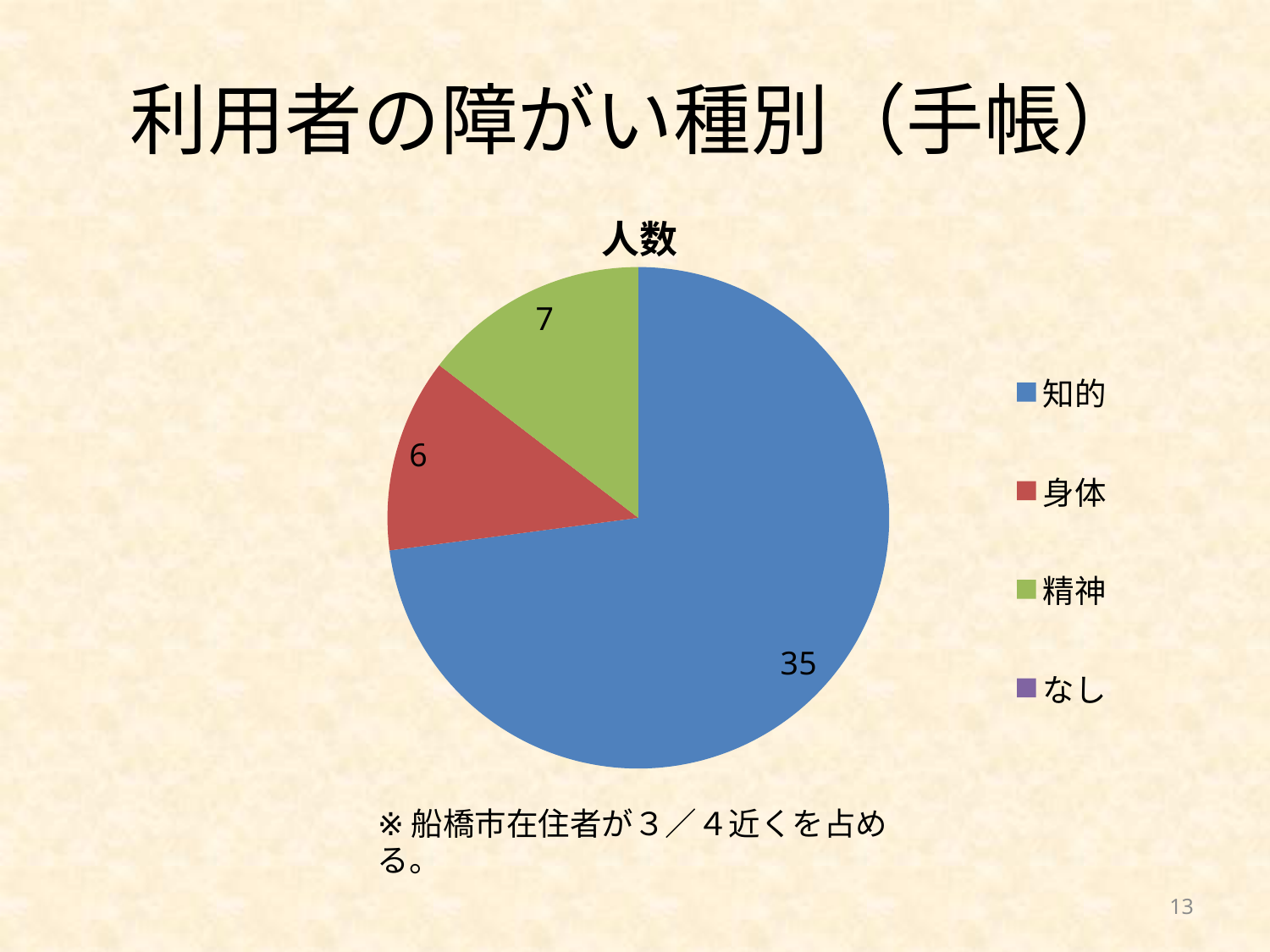
Which of the labelled slices is the smallest? 身体 What type of chart is shown on the slide? pie chart What is the difference between the values for 精神 and 身体? 1 What is the title of the chart? 人数 What colour is the slice for 知的? blue What is the difference between the values for 知的 and 精神? 28 Which is larger, the value for 身体 or the value for 精神? 精神 Which category has the largest slice? 知的 What is the value for 身体? 6 What is the value for 知的? 35 What is the value for 精神? 7 How many entries does the legend list? 4